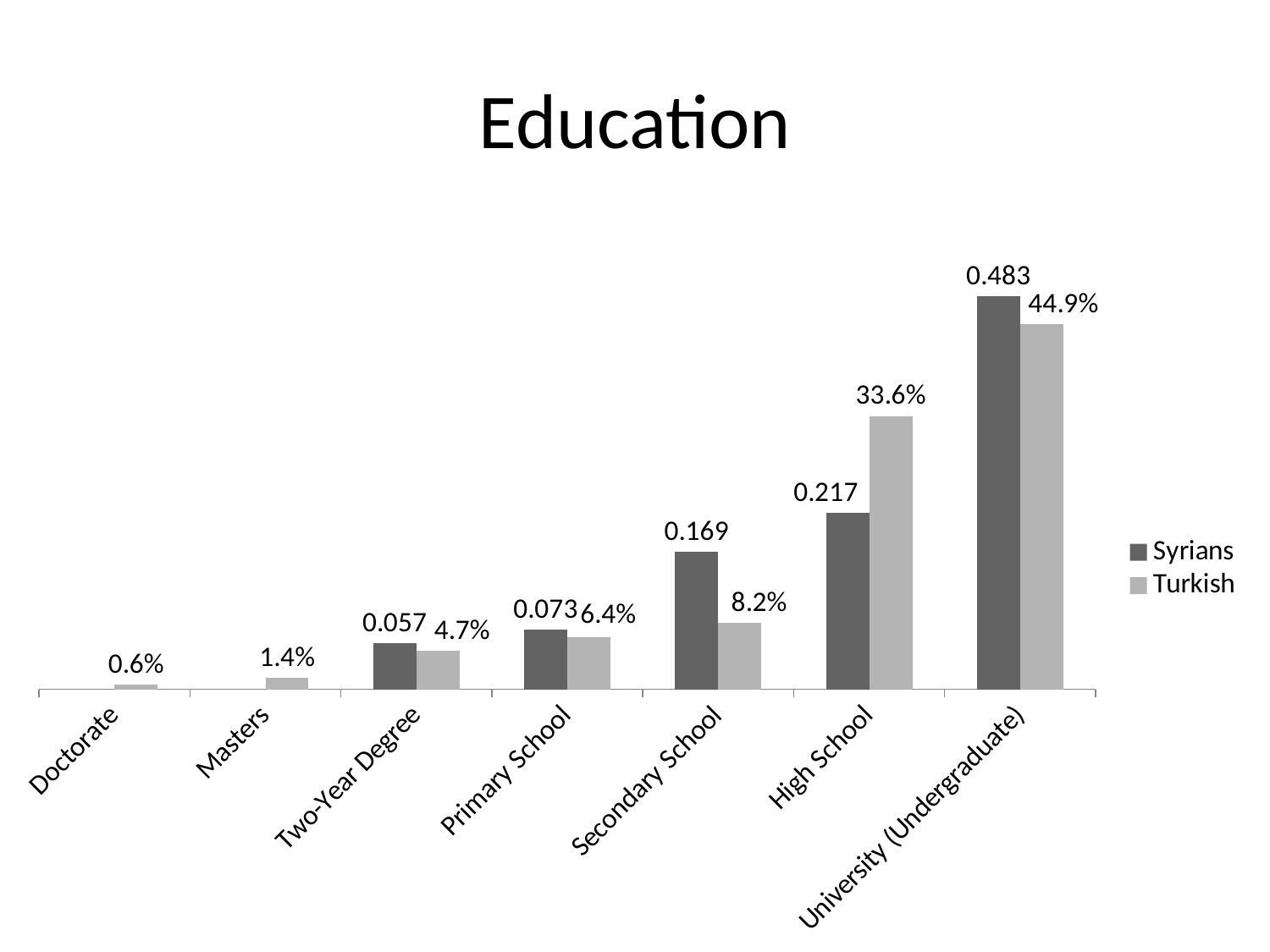
What is the value for Turkish in the Doctorate category? 0.6% In the High School category, which series has the larger value, Syrians or Turkish? Turkish Which category has the highest value for the Turkish series? University (Undergraduate) What is the value for Turkish in the High School category? 33.6% What is the value for Syrians in the University (Undergraduate) category? 0.483 In the University (Undergraduate) category, which series has the larger value, Syrians or Turkish? Syrians How many series does the legend list? 2 What is the difference between the Turkish values for University (Undergraduate) and High School? 11.3% What is the value for Syrians in the Secondary School category? 0.169 How many education categories are shown on the x axis? 7 What kind of chart is shown on the slide? Bar chart Which category has the lowest value for the Turkish series? Doctorate